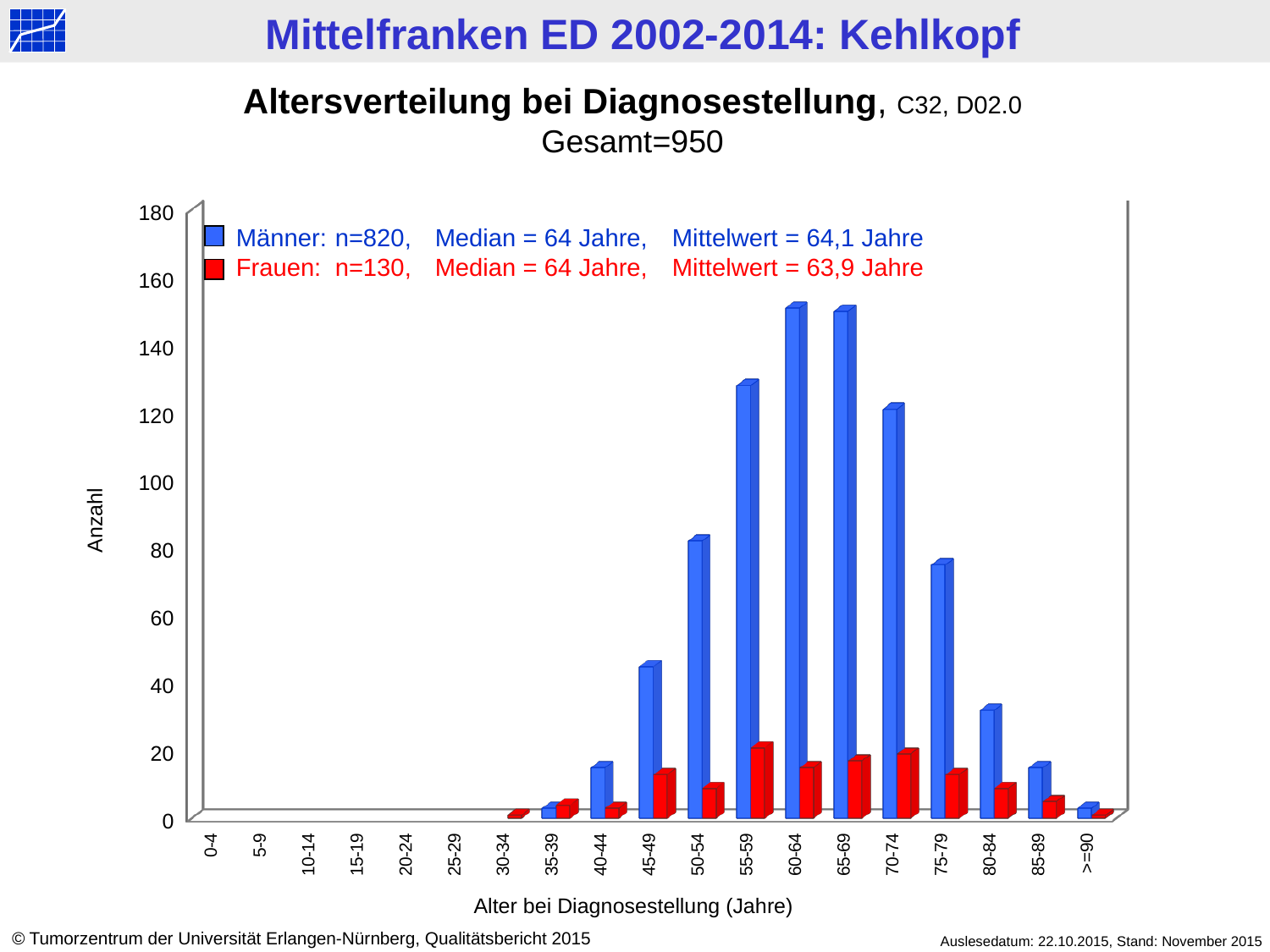
Is the value for Frauen in the 55-59 age group greater or less than 40? less Is the value for Männer in the 70-74 age group greater or less than 100? greater Which is larger for Männer, the value for 45-49 or for 80-84? 45-49 Is the value for Männer in the 80-84 age group greater or less than 20? greater Which is larger in the 60-64 age group, the value for Männer or for Frauen? Männer What kind of chart is shown on the slide? bar chart Do the values for Männer rise or fall from the 65-69 age group to the >=90 age group? fall How many series does the legend list? 2 According to the legend, what is n for Männer? n=820 How many age groups are shown on the x axis? 19